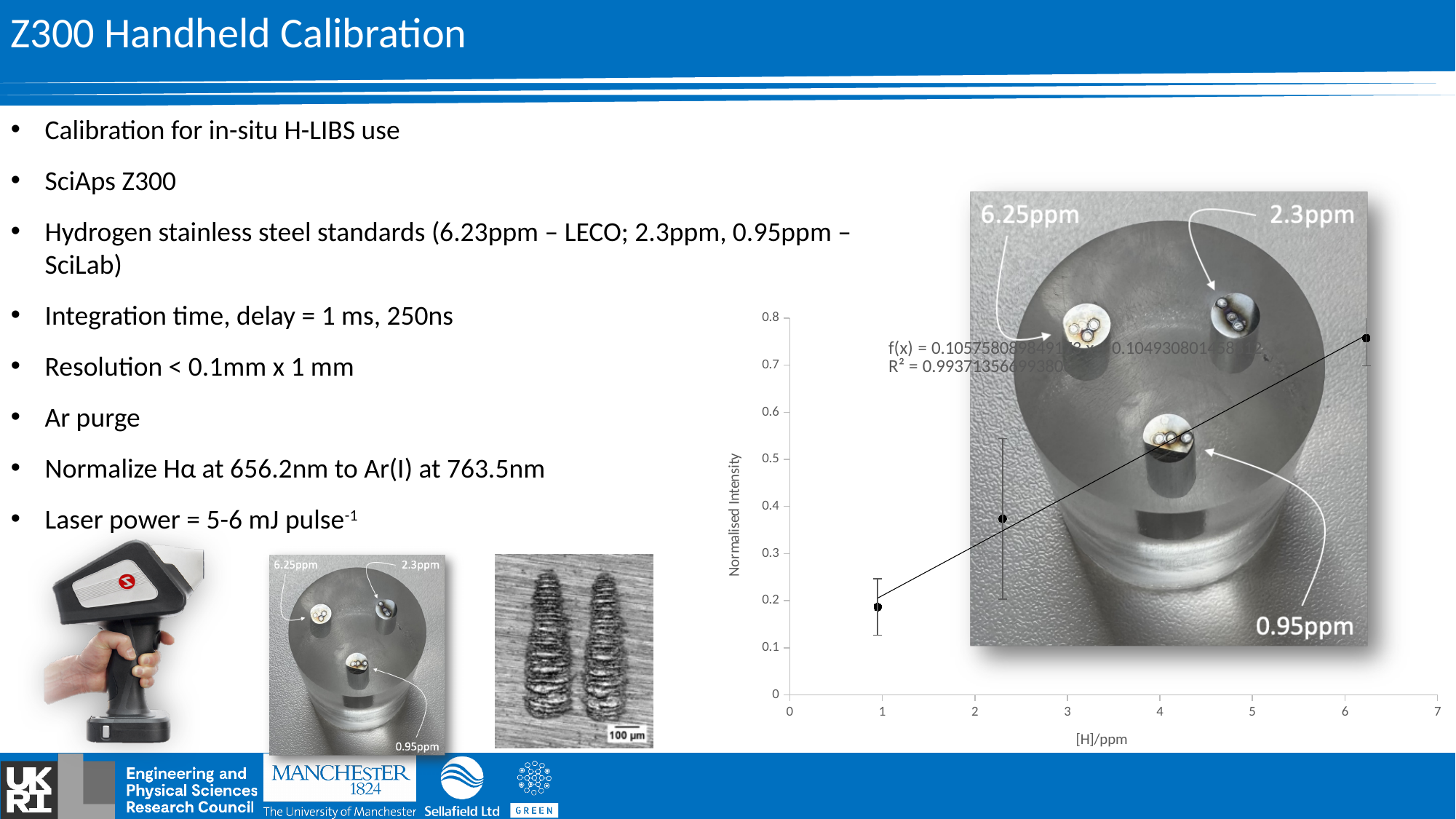
Is the normalised intensity for the point at about 2.3 ppm greater or less than 0.4? less What is the label of the x axis of the chart? [H]/ppm Which plotted point has the lowest normalised intensity: the one at about 0.95 ppm, 2.3 ppm or 6.25 ppm? 0.95 ppm How many data points are plotted on the chart? 3 Which plotted point has the highest normalised intensity: the one at about 0.95 ppm, 2.3 ppm or 6.25 ppm? 6.25 ppm Is the normalised intensity for the point at about 6.25 ppm greater or less than 0.7? greater Is the normalised intensity for the point at about 2.3 ppm greater or less than 0.3? greater Does the normalised intensity rise or fall as [H]/ppm increases? rise What kind of chart is shown on the slide? scatter chart What is the label of the y axis of the chart? Normalised Intensity Is the normalised intensity higher for the point at about 6.25 ppm or the point at about 2.3 ppm? 6.25 ppm